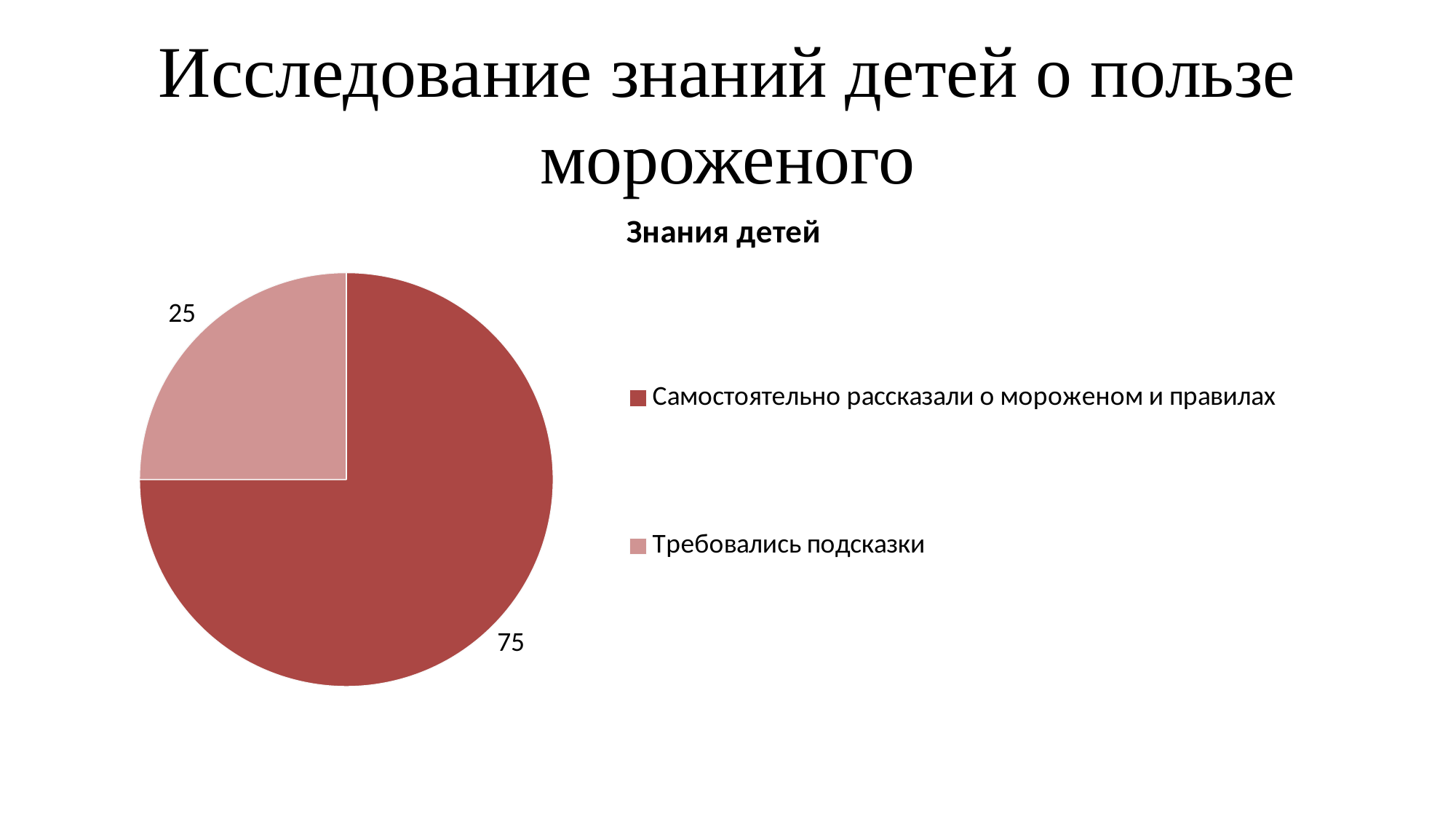
Which category has the smallest slice? Требовались подсказки What share of the pie does "Самостоятельно рассказали о мороженом и правилах" represent? 75% How many slices does the pie chart have? 2 What share of the pie does "Требовались подсказки" represent? 25% What is the value for "Самостоятельно рассказали о мороженом и правилах"? 75 What is the value for "Требовались подсказки"? 25 What kind of chart is shown on the slide? pie chart Which category has the largest slice? Самостоятельно рассказали о мороженом и правилах How many entries does the legend list? 2 Which is larger: "Самостоятельно рассказали о мороженом и правилах" or "Требовались подсказки"? Самостоятельно рассказали о мороженом и правилах What is the title of the chart? Знания детей What is the difference between the values for "Самостоятельно рассказали о мороженом и правилах" and "Требовались подсказки"? 50